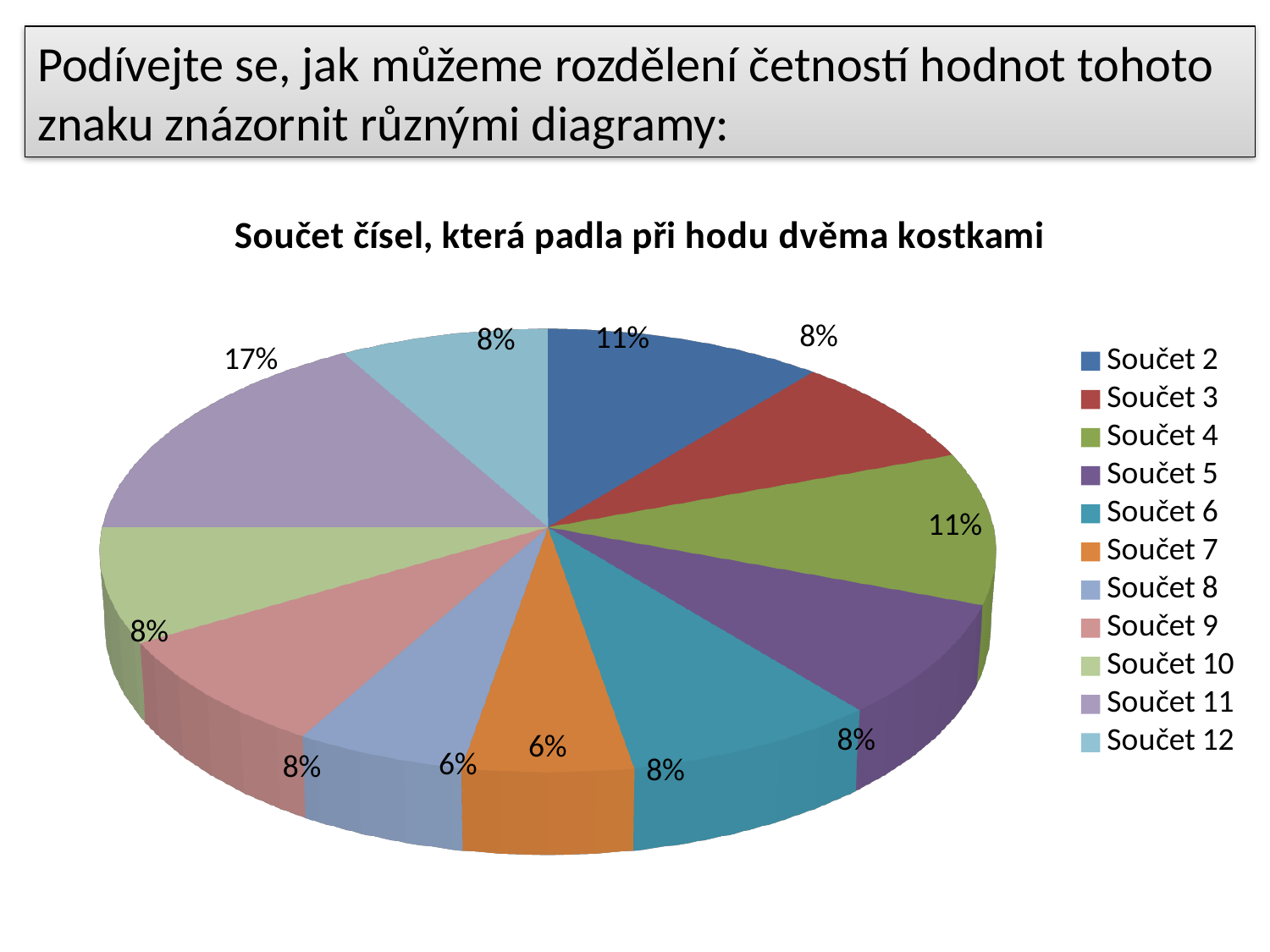
How many categories does the pie chart have? 11 What type of chart is shown on the slide? pie chart Which legend entry is shown in orange? Součet 7 Which category has the largest share of the pie? Součet 11 What is the difference in percentage points between the share for Součet 11 and the share for Součet 2? 6 What is the value shown for Součet 7? 6% What share of the pie does Součet 11 have? 17% Which is larger, the share for Součet 11 or the share for Součet 4? Součet 11 What is the title of the chart? Součet čísel, která padla při hodu dvěma kostkami What is the value shown for Součet 2? 11% What is the value shown for Součet 4? 11% What is the value shown for Součet 12? 8%